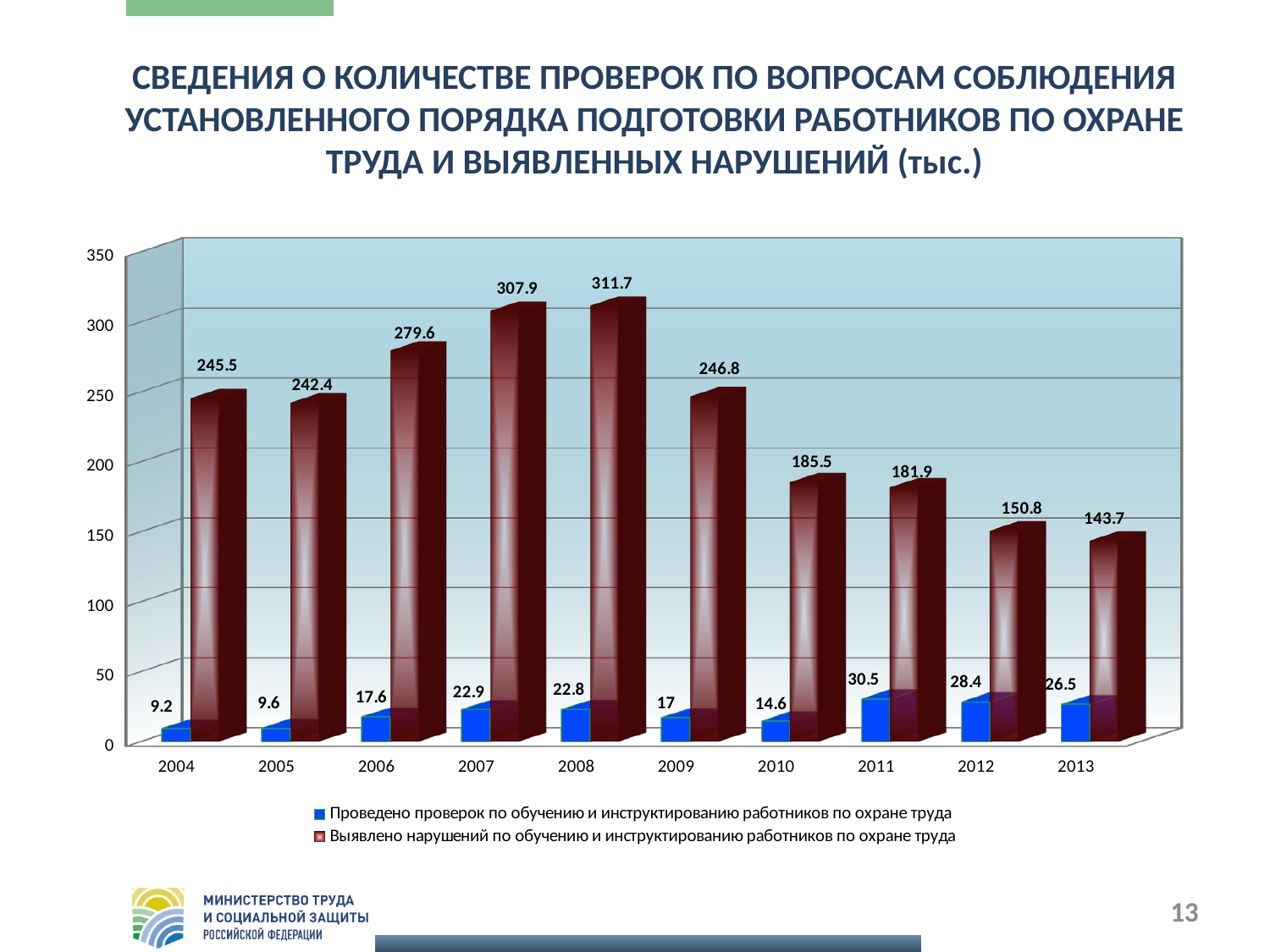
Which is larger: the 'Проведено проверок' value for 2007 or for 2012? 2012 Is the 'Выявлено нарушений' value for 2010 greater or less than 200? less Does the 'Выявлено нарушений' series rise or fall from 2008 to 2013? fall What is the difference between the 'Выявлено нарушений' values for 2008 and 2013? 168 In which year is the 'Выявлено нарушений' series highest? 2008 What is the value of the 'Выявлено нарушений по обучению и инструктированию работников по охране труда' series for 2008? 311.7 How many years are shown on the x axis of the chart? 10 What kind of chart is shown on the slide? bar chart What is the value of the 'Выявлено нарушений' series for 2013? 143.7 How many series does the legend list? 2 What is the value of the 'Проведено проверок по обучению и инструктированию работников по охране труда' series for 2011? 30.5 In which year is the 'Проведено проверок' series lowest? 2004